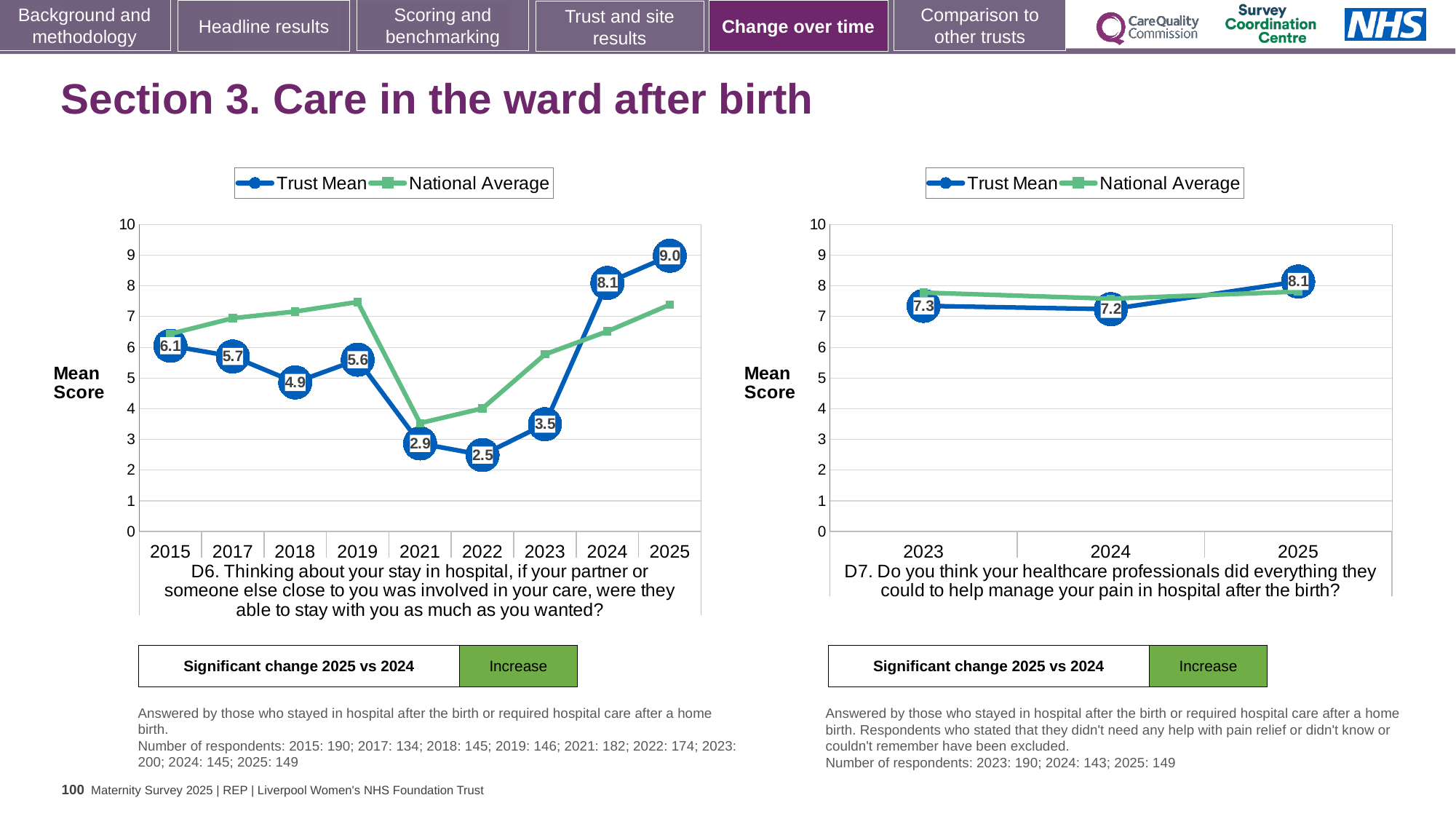
In the left chart (D6), is the National Average for 2019 greater or less than 7? greater In the left chart (D6), how many years are shown on the x axis? 9 How many series does the legend of the right chart (D7) list? 2 In the right chart (D7), which year has the highest Trust Mean? 2025 In the left chart (D6), what is the difference between the Trust Mean for 2025 and 2024? 0.9 In the left chart (D6), what is the Trust Mean for 2022? 2.5 What type of chart is the left chart (D6)? Line chart In the right chart (D7), what is the Trust Mean for 2024? 7.2 In the right chart (D7), what is the difference between the Trust Mean for 2025 and 2023? 0.8 In the left chart (D6), what is the Trust Mean for 2025? 9.0 In the left chart (D6), which year has the highest Trust Mean? 2025 In the left chart (D6), which year has the lowest Trust Mean? 2022